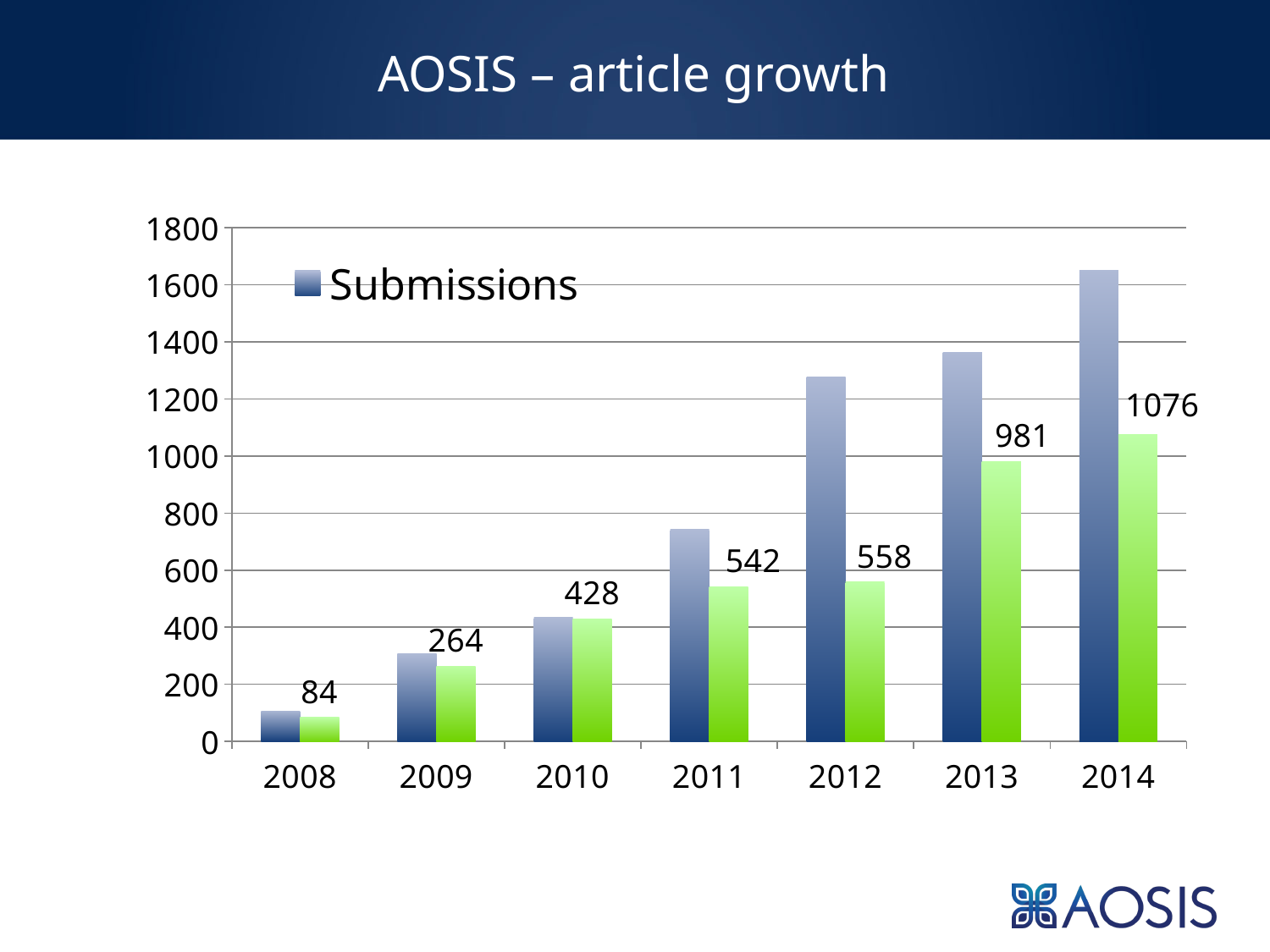
What is the value of the green bar for 2010? 428 Is the Submissions value for 2014 greater or less than 1600? greater Which year has the lowest value among the green bars? 2008 What is the value of the green bar for 2008? 84 How many years are shown on the x axis of the chart? 7 What kind of chart is shown on the slide? bar chart What is the difference between the green bar values for 2013 and 2012? 423 Which year has the highest value among the green bars? 2014 Is the Submissions value for 2011 greater or less than 800? less What is the value of the green bar for 2014? 1076 What is the title of the chart on the slide? AOSIS – article growth Do the Submissions values rise or fall from 2008 to 2014? rise